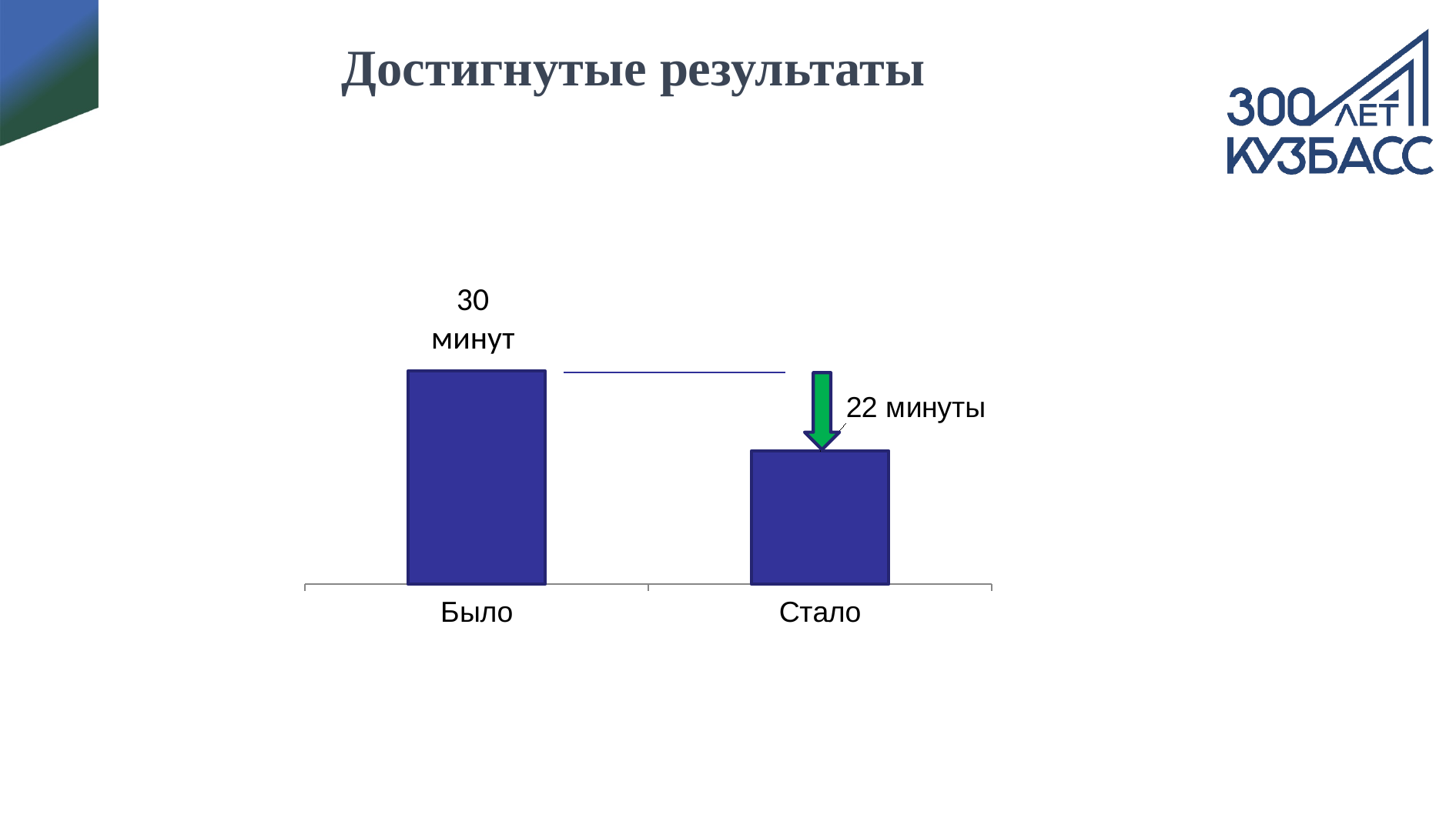
Do the values rise or fall from Было to Стало? fall What is the difference in minutes between Было and Стало? 8 What is the value for Стало? 22 минуты Which category has the highest value? Было What kind of chart is shown on the slide? bar chart What colour are the bars in the chart? blue Which category has the lowest value? Стало How many bars are shown in the chart? 2 What is the title of the slide containing the chart? Достигнутые результаты Which is larger, the value for Было or the value for Стало? Было What is the value for Было? 30 минут